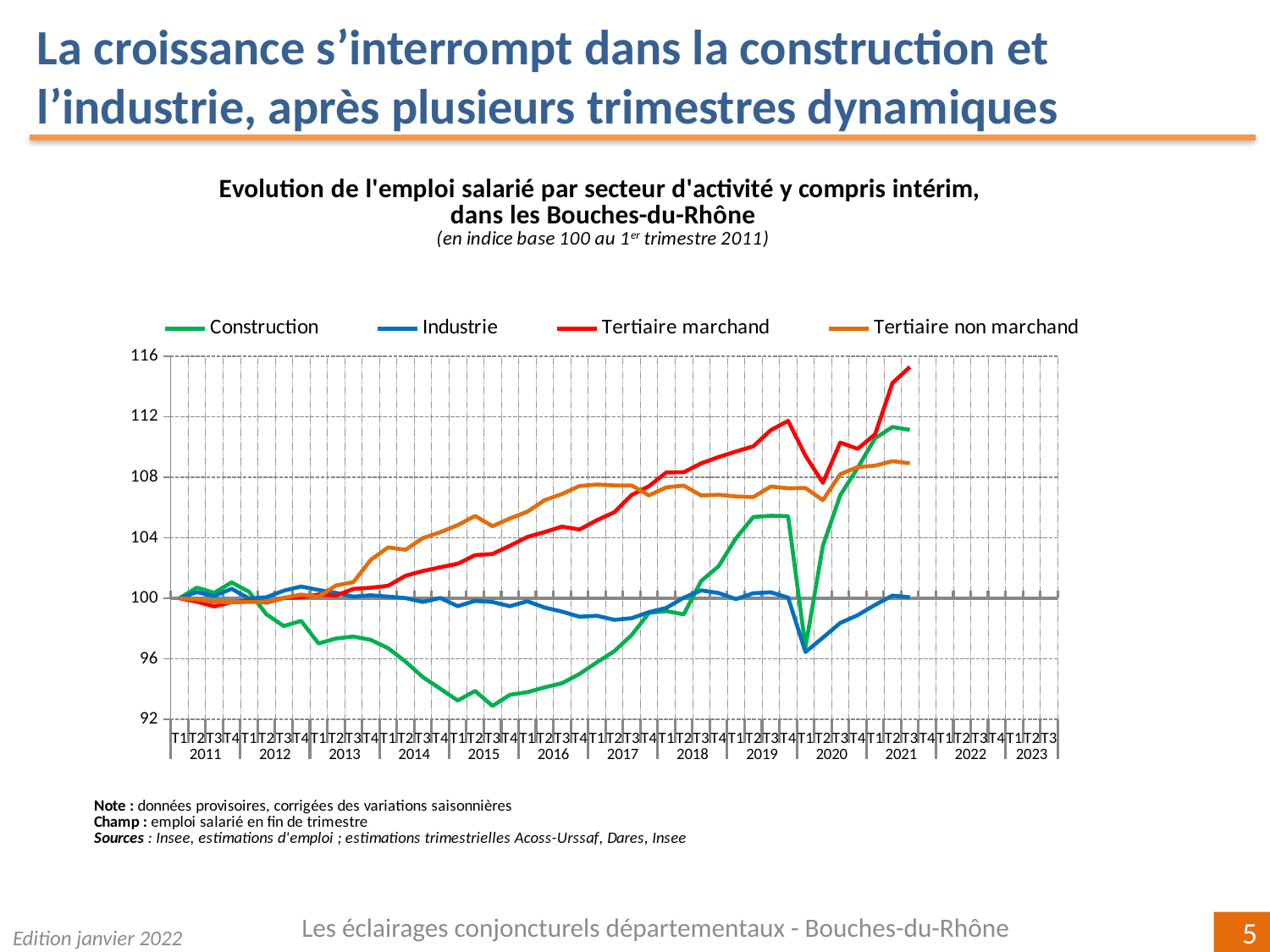
Does the Construction series rise or fall between T1 2011 and T3 2015? fall Which series has the lowest value at T3 2021? Industrie What is the index value of all series at T1 2011? 100 Is the value for Industrie at T1 2020 greater or less than 100? less At T1 2020, which is larger: Industrie or Tertiaire non marchand? Tertiaire non marchand What kind of chart is shown on the slide? line chart Is the value for Construction at T3 2015 greater or less than 96? less How many series does the legend list? 4 Which series has the highest value at T3 2021? Tertiaire marchand Is the value for Tertiaire marchand at T3 2021 greater or less than 112? greater Which colour is used for the Industrie series? blue